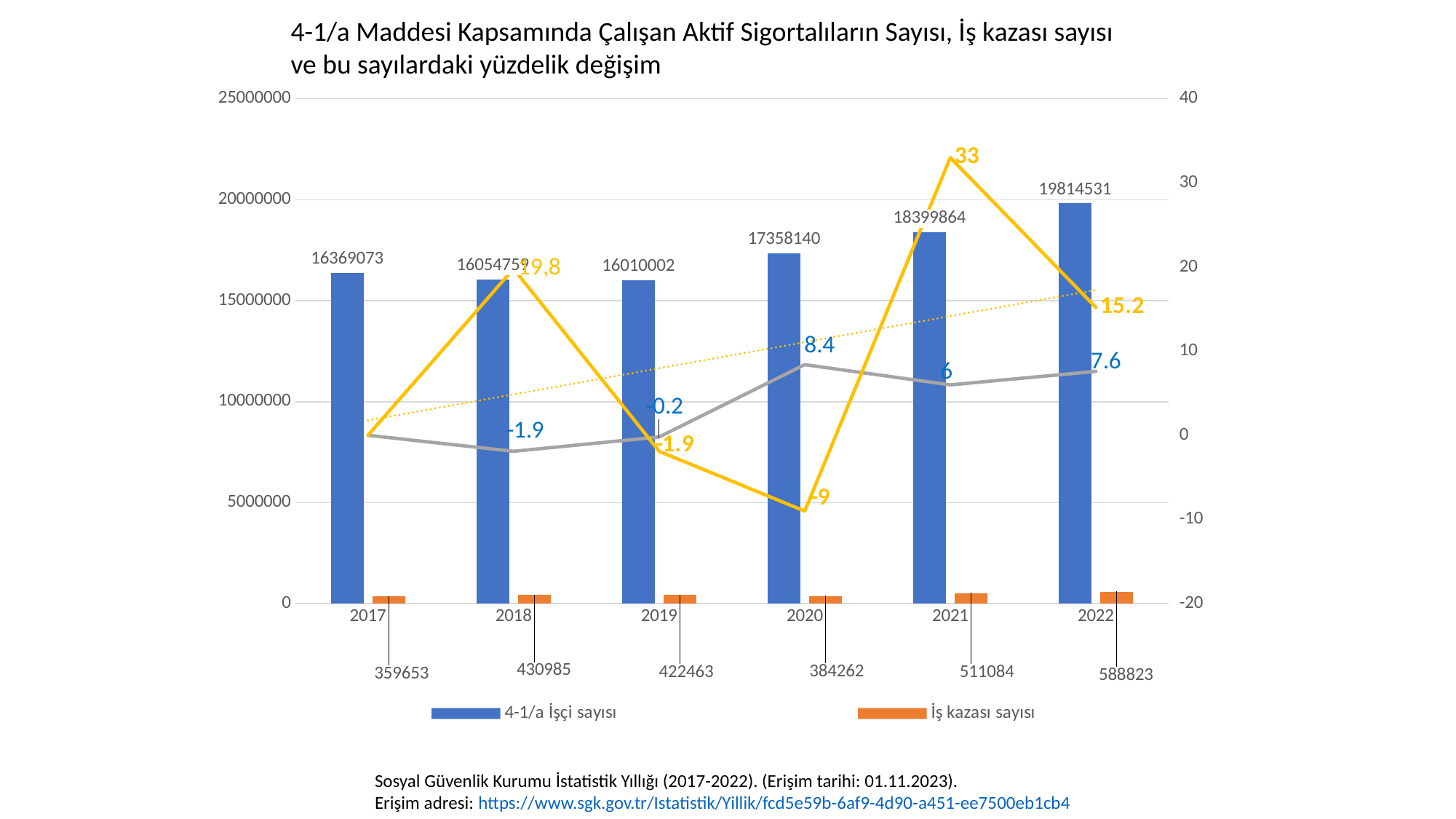
Which is larger, the İş kazası sayısı for 2018 or for 2020? 2018 What is the value of 4-1/a İşçi sayısı for 2022? 19814531 Does the 4-1/a İşçi sayısı rise or fall from 2019 to 2022? rise What colour are the bars for İş kazası sayısı? orange How many years are shown on the x axis? 6 How many series does the legend list? 2 Which year has the highest İş kazası sayısı? 2022 Which year has the lowest 4-1/a İşçi sayısı? 2019 What is the difference between the 4-1/a İşçi sayısı values for 2022 and 2021? 1414667 What is the value of İş kazası sayısı for 2019? 422463 What is the value of 4-1/a İşçi sayısı for 2017? 16369073 What is the highest value labelled on the yellow line? 33